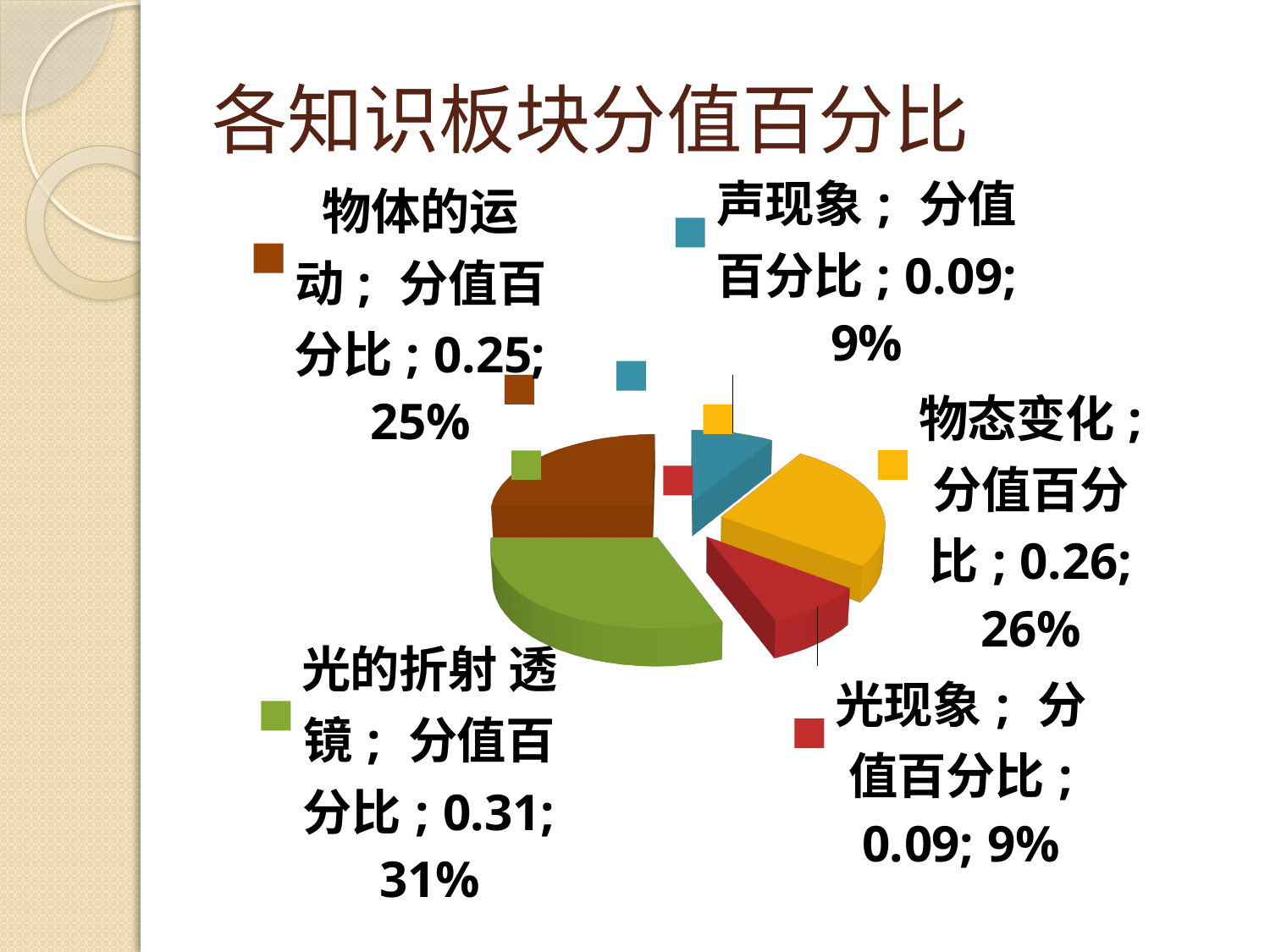
How many slices does the pie chart have? 5 What colour is the slice for 光的折射 透镜? green What is the difference in percentage points between 光的折射 透镜 and 物体的运动? 6% Which is larger, the share for 物态变化 or the share for 物体的运动? 物态变化 What percentage is shown for 物态变化? 26% What percentage is shown for 声现象? 9% What is the title of the chart? 各知识板块分值百分比 What kind of chart is shown on the slide? pie chart Which knowledge area has the largest share of the pie? 光的折射 透镜 What percentage is shown for 光的折射 透镜? 31% What percentage is shown for 光现象? 9% What percentage is shown for 物体的运动? 25%